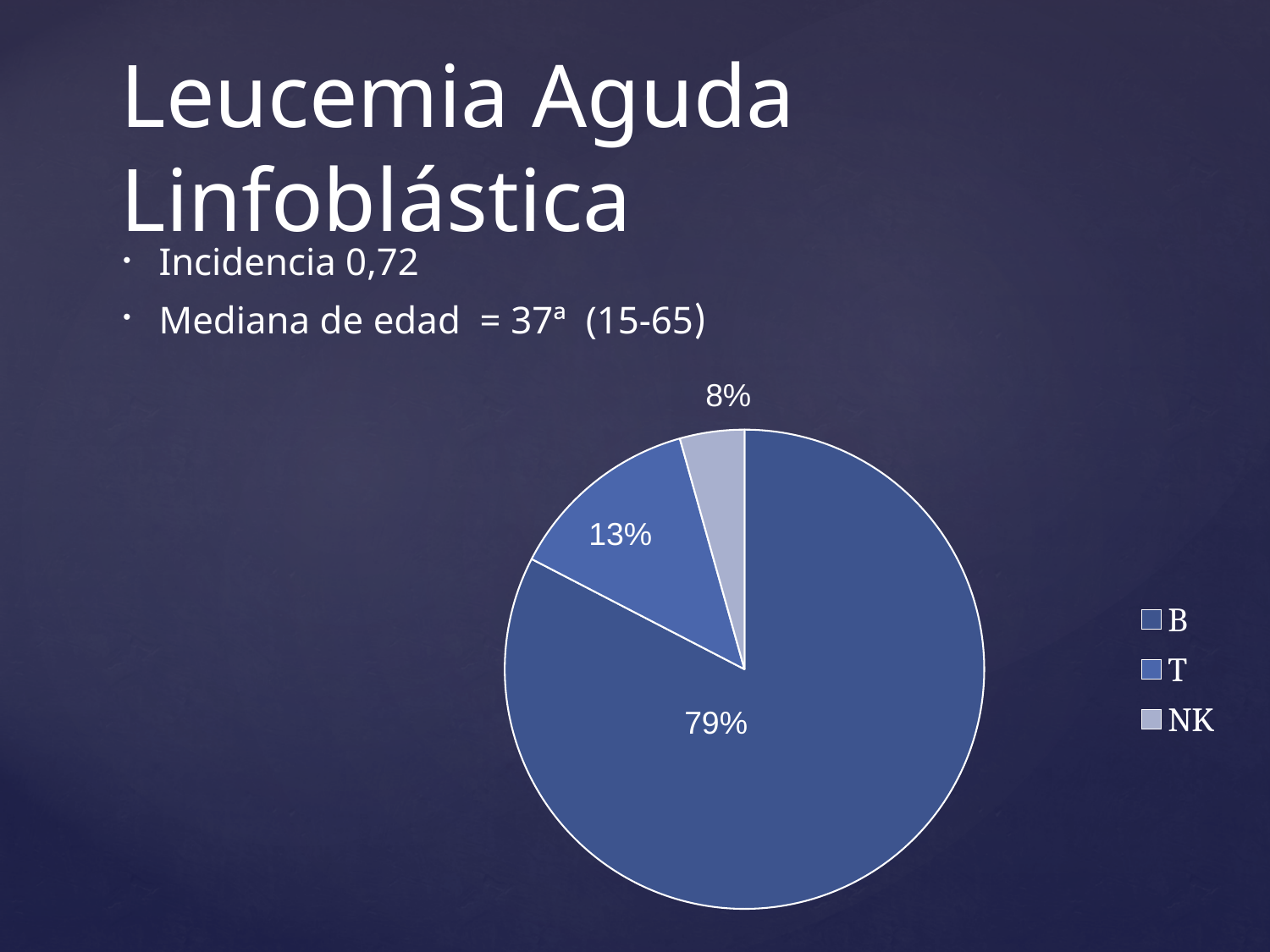
What is the difference in percentage points between the T slice and the NK slice? 5 What share of the pie does the B slice represent? 79% Which category has the smallest slice of the pie? NK Which category has the largest slice of the pie? B What share of the pie does the T slice represent? 13% Which is larger, the T slice or the NK slice? T What kind of chart is shown on the slide? pie chart How many slices does the pie chart have? 3 Which legend entry is shown with the lightest colour? NK What share of the pie does the NK slice represent? 8% What is the difference in percentage points between the B slice and the T slice? 66 How many entries does the legend list? 3